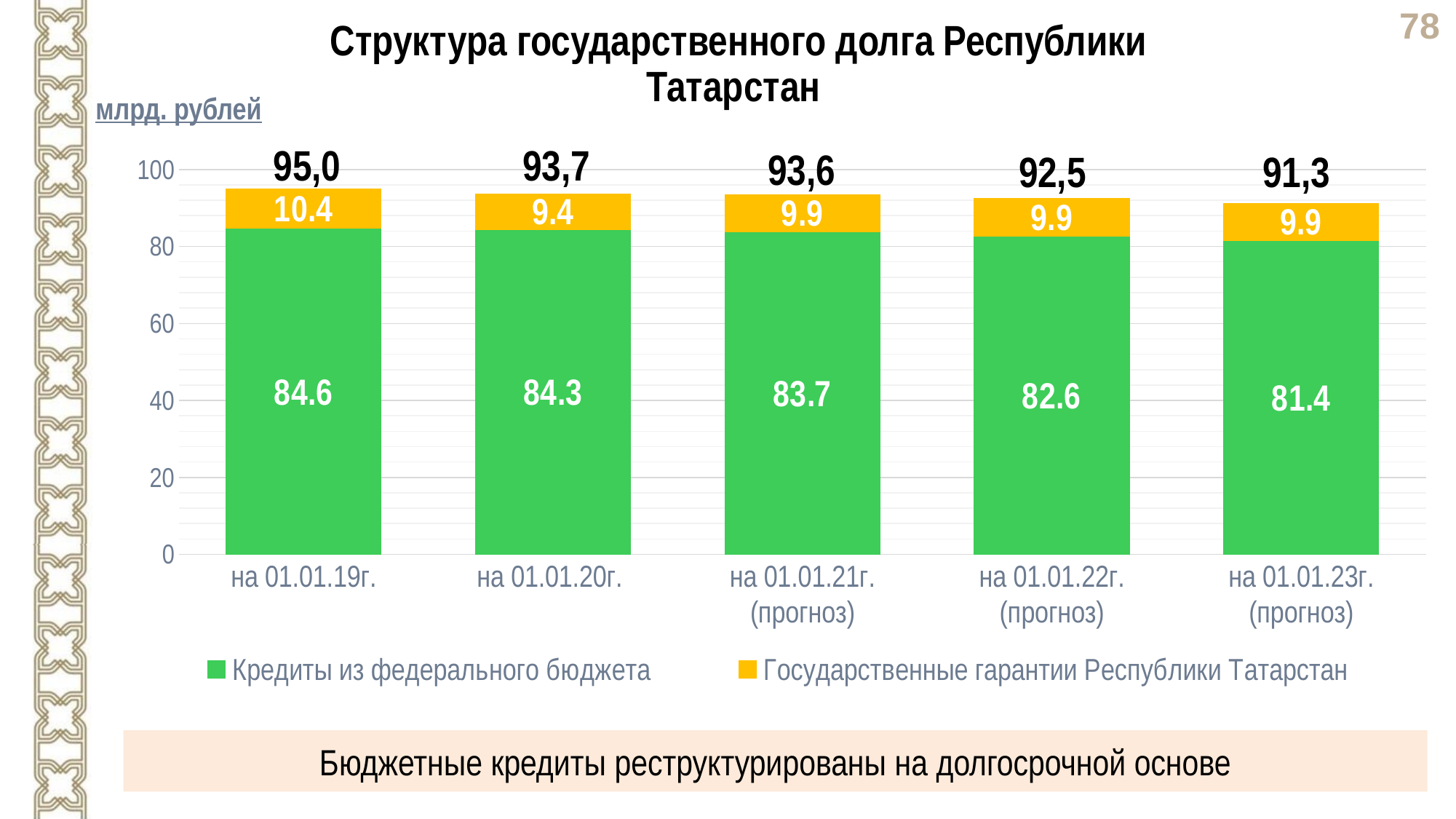
Does the value of 'Кредиты из федерального бюджета' rise or fall from 01.01.19г. to 01.01.23г. (прогноз)? Fall What type of chart is shown on the slide? Stacked bar chart What is the value of 'Кредиты из федерального бюджета' на 01.01.19г.? 84.6 What is the value of 'Государственные гарантии Республики Татарстан' на 01.01.20г.? 9.4 What unit of measurement is indicated for the chart? млрд. рублей Which date has the highest value for 'Кредиты из федерального бюджета'? на 01.01.19г. How many series does the legend list? 2 How many dates (categories) are shown on the x axis? 5 What is the total state debt shown above the bar for 01.01.23г. (прогноз)? 91,3 Which date has the lowest value for 'Государственные гарантии Республики Татарстан'? на 01.01.20г. What is the total shown above the bar for 01.01.21г. (прогноз)? 93,6 What is the difference between the 'Кредиты из федерального бюджета' values for 01.01.19г. and 01.01.23г. (прогноз)? 3.2